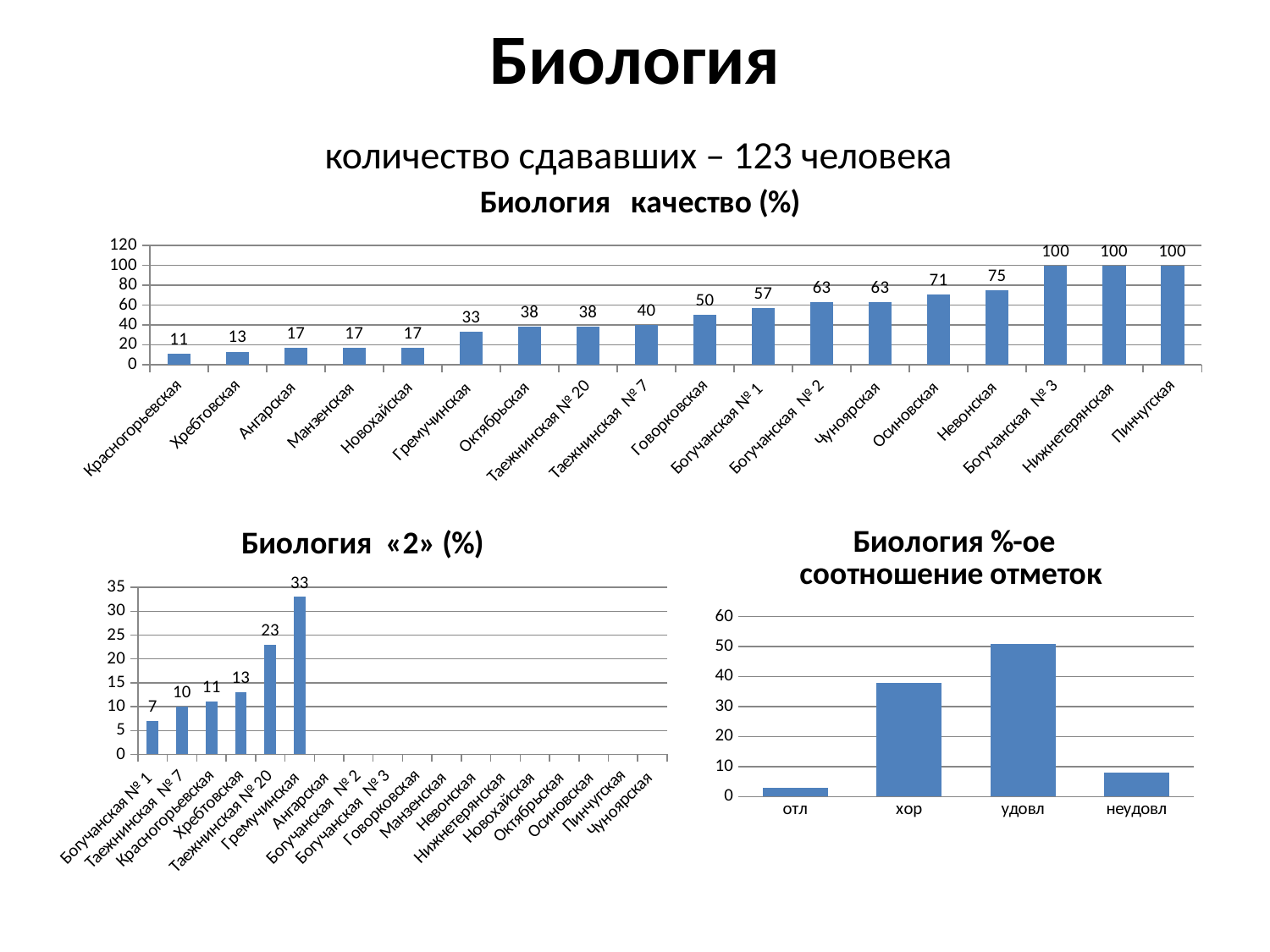
In the chart titled "Биология «2» (%)", what is the difference between the values for Хребтовская and Богучанская № 1? 6 In the chart titled "Биология качество (%)", what is the value for Гремучинская? 33 In the chart titled "Биология качество (%)", how many categories are shown on the x axis? 18 In the chart titled "Биология качество (%)", what is the difference between the values for Невонская and Говорковская? 25 In the chart titled "Биология %-ое соотношение отметок", which category has the lowest value? отл What kind of chart is the chart titled "Биология %-ое соотношение отметок"? bar chart In the chart titled "Биология качество (%)", which is larger, the value for Октябрьская or the value for Богучанская № 1? Богучанская № 1 In the chart titled "Биология «2» (%)", which category has the highest value? Гремучинская In the chart titled "Биология качество (%)", which category has the lowest value? Красногорьевская In the chart titled "Биология «2» (%)", what is the value for Таежнинская № 20? 23 In the chart titled "Биология качество (%)", what is the value for Осиновская? 71